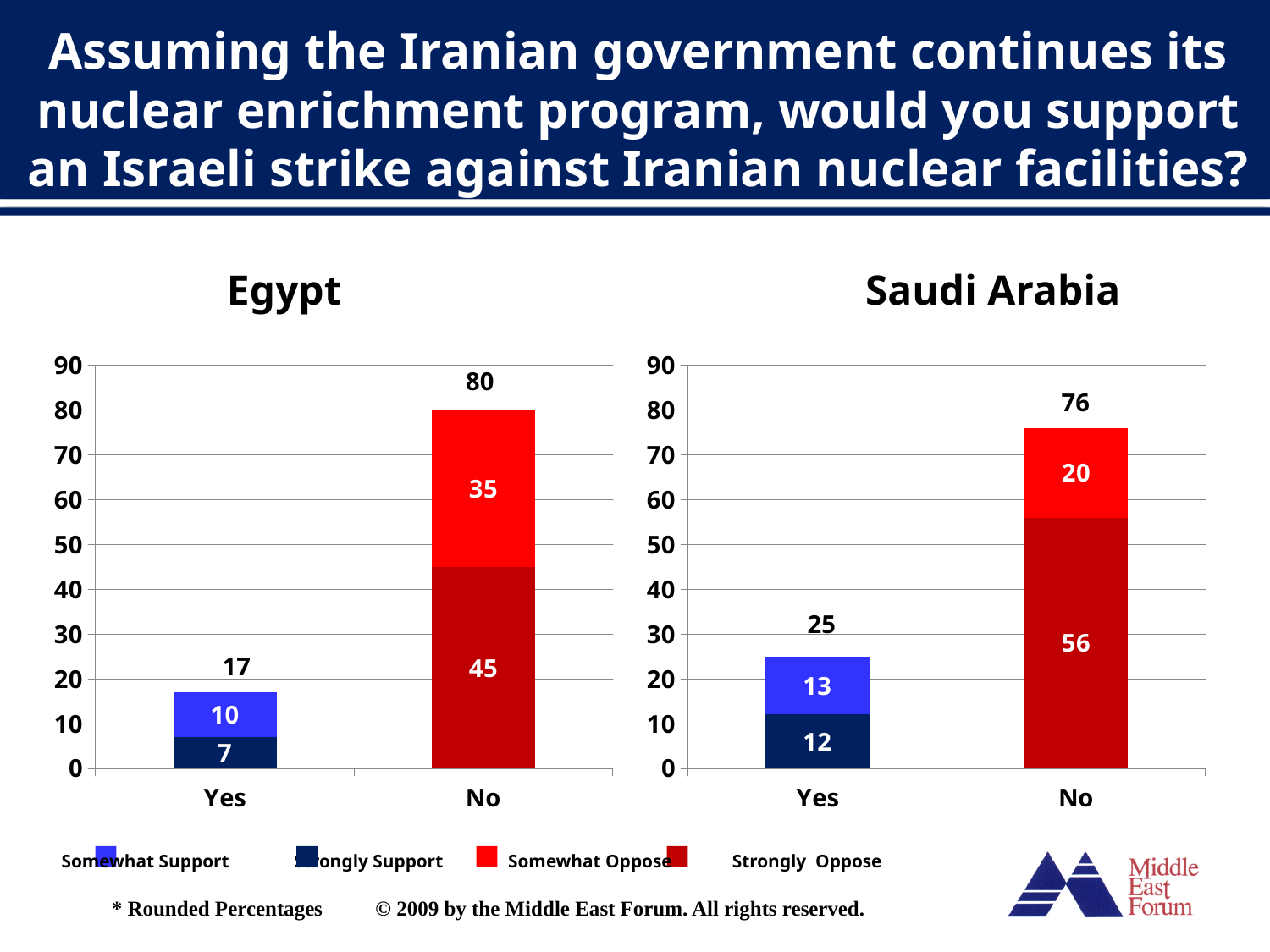
What kind of chart is the Saudi Arabia chart? Stacked bar chart In the Egypt chart, what is the total for the No bar? 80 In the Egypt chart, what is the Strongly Support value for Yes? 7 In the Saudi Arabia chart, what is the Somewhat Oppose value for No? 20 In the Egypt chart, which category has the higher total, Yes or No? No In the Egypt chart, what is the Strongly Oppose value for No? 45 In the Saudi Arabia chart, what is the total for the Yes bar? 25 What is the title of the chart on the left? Egypt In the Saudi Arabia chart, what is the Somewhat Support value for Yes? 13 In the Saudi Arabia chart, which is larger, the Strongly Oppose value for No or the Somewhat Oppose value for No? Strongly Oppose How many series does the legend list? 4 In the Egypt chart, what is the difference between the No total and the Yes total? 63